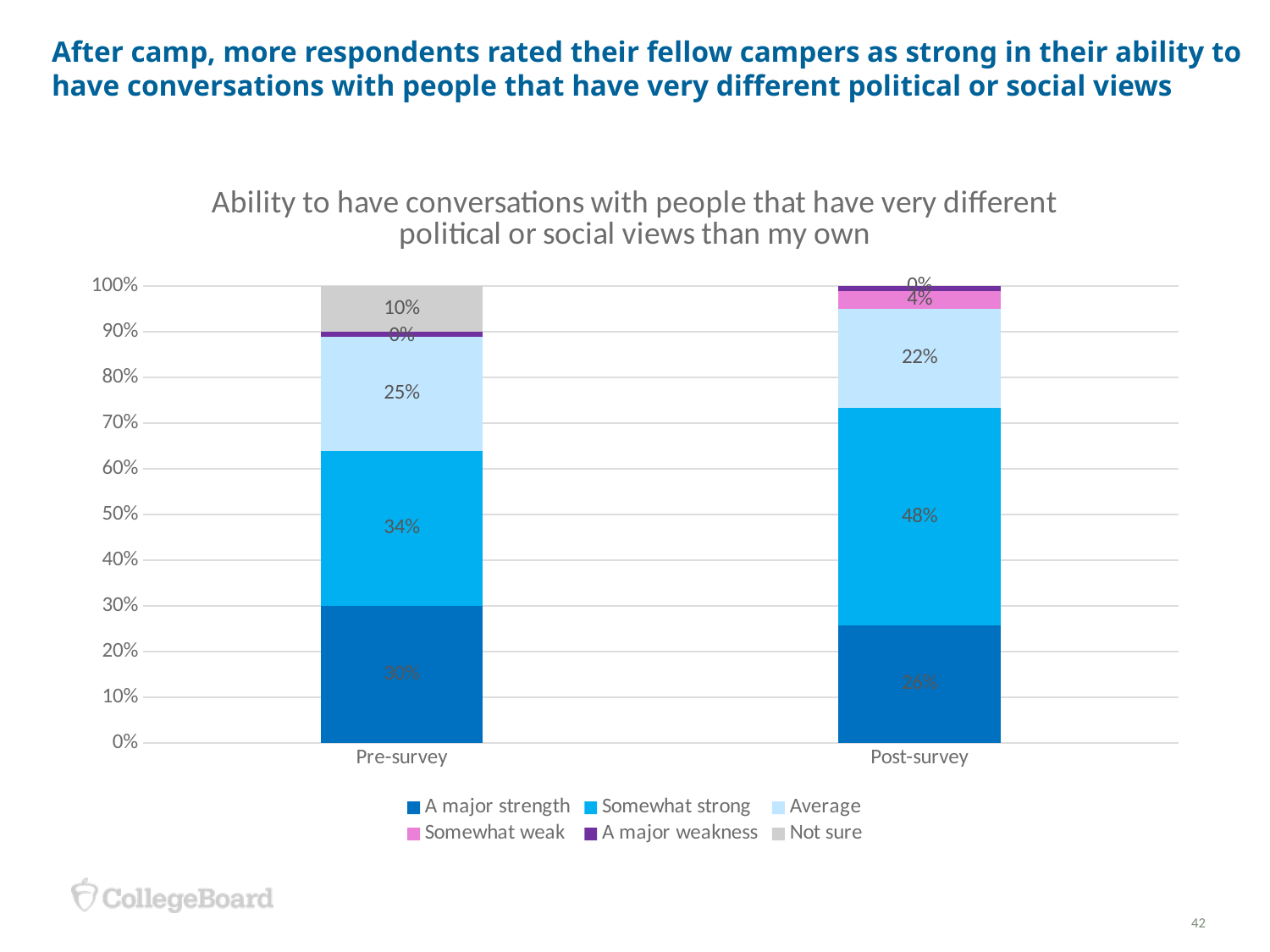
What is the "A major strength" value for the Pre-survey bar? 30% What is the "Average" value for the Post-survey bar? 22% How many series does the legend list? 6 What percentage of Pre-survey respondents rated the ability as "Somewhat strong"? 34% What percentage of Post-survey respondents rated the ability as "Somewhat strong"? 48% What kind of chart is shown on the slide? Stacked bar chart Which survey has the larger "Average" share, Pre-survey or Post-survey? Pre-survey How many bars (survey categories) are shown on the x axis? 2 What is the "Somewhat weak" value for the Post-survey bar? 4% What is the "Not sure" value for the Pre-survey bar? 10% Which response category is the largest segment of the Post-survey bar? Somewhat strong By how many percentage points did the "Somewhat strong" share increase from Pre-survey to Post-survey? 14 percentage points